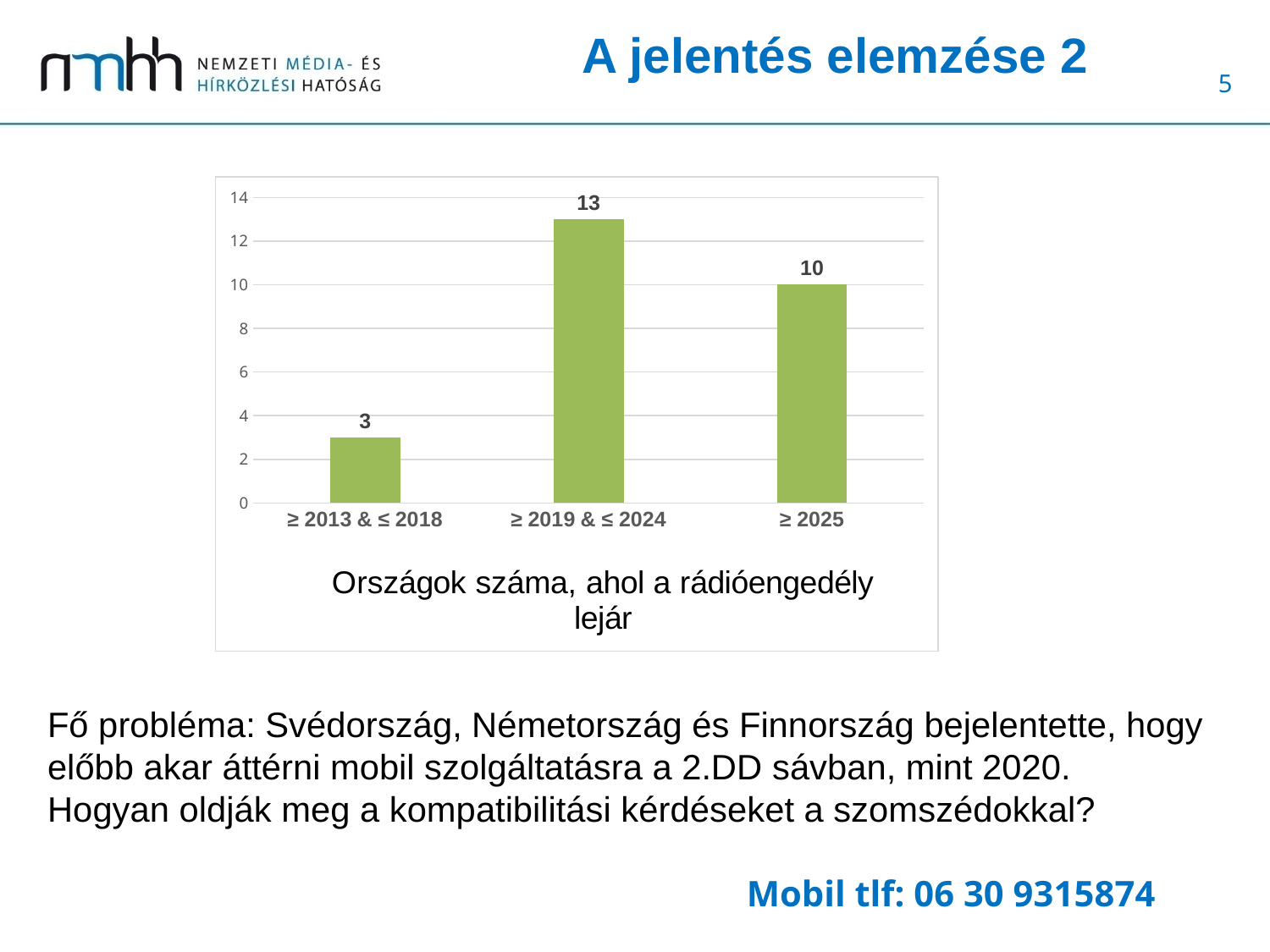
What kind of chart is shown on the slide? bar chart What is the value for the category "≥ 2025"? 10 What is the difference between the values for "≥ 2025" and "≥ 2013 & ≤ 2018"? 7 What is the value for the category "≥ 2013 & ≤ 2018"? 3 What is the value for the category "≥ 2019 & ≤ 2024"? 13 How many categories are shown on the x axis? 3 What is the difference between the values for "≥ 2019 & ≤ 2024" and "≥ 2025"? 3 Which category has the lowest value? ≥ 2013 & ≤ 2018 Is the value for "≥ 2019 & ≤ 2024" greater or less than 12? greater What is the title of the chart? Országok száma, ahol a rádióengedély lejár Which category has the highest value? ≥ 2019 & ≤ 2024 Which is larger, the value for "≥ 2025" or the value for "≥ 2013 & ≤ 2018"? ≥ 2025